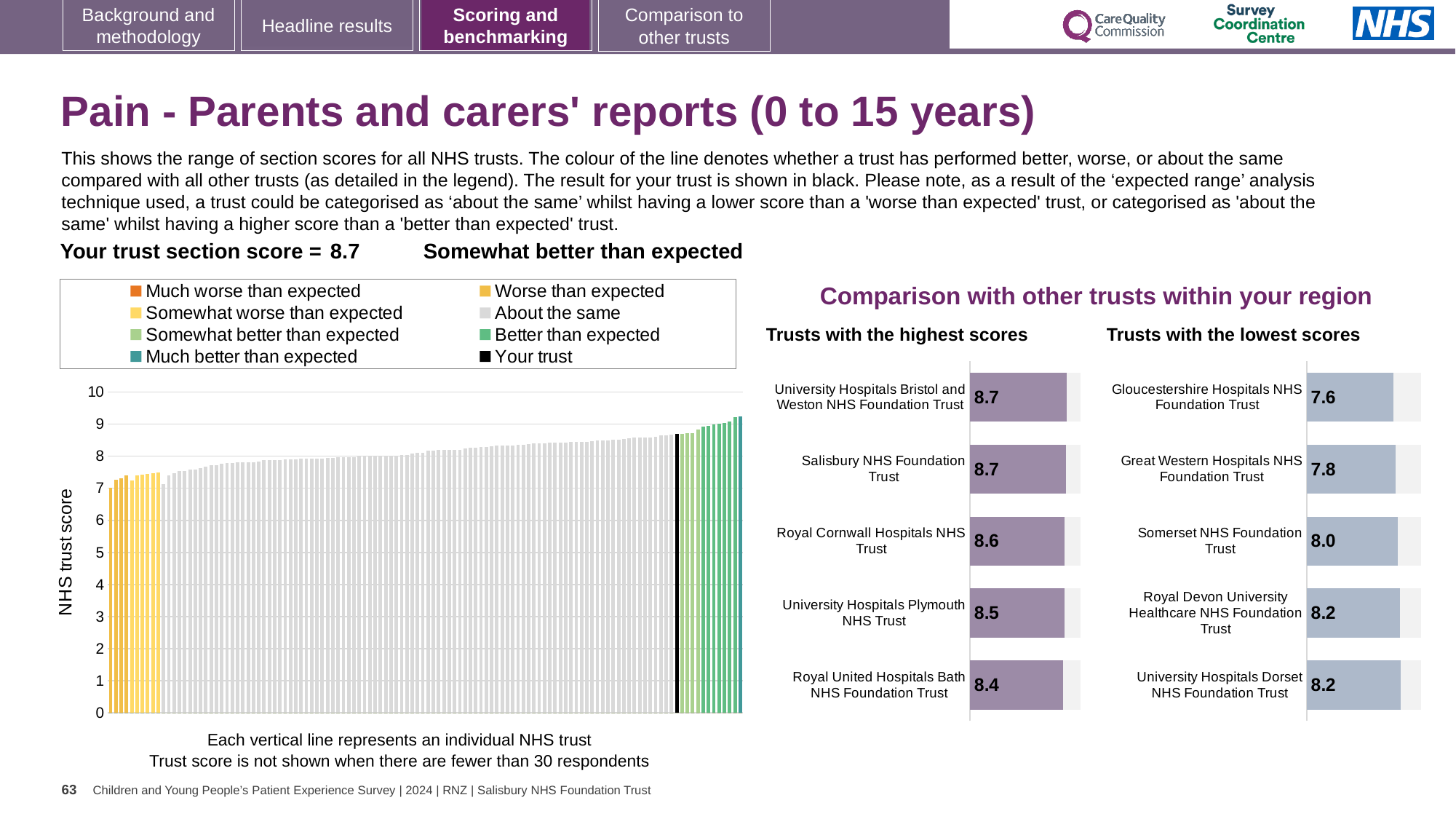
In the 'Trusts with the lowest scores' chart, what is the difference between the scores of Great Western Hospitals NHS Foundation Trust and Gloucestershire Hospitals NHS Foundation Trust? 0.2 In the 'Trusts with the lowest scores' chart, what is the score for Somerset NHS Foundation Trust? 8.0 In the 'Trusts with the lowest scores' chart, which trust has the lowest score? Gloucestershire Hospitals NHS Foundation Trust In the 'Trusts with the highest scores' chart, which trust has the lowest score shown? Royal United Hospitals Bath NHS Foundation Trust How many entries does the legend of the main chart on the left list? 8 How many trusts are listed in the 'Trusts with the lowest scores' chart? 5 In the 'Trusts with the lowest scores' chart, what is the score for Gloucestershire Hospitals NHS Foundation Trust? 7.6 In the 'Trusts with the highest scores' chart, what is the score for Royal Cornwall Hospitals NHS Trust? 8.6 In the main chart on the left, is the value for the black 'Your trust' bar greater or less than 8? greater In the 'Trusts with the highest scores' chart, what is the score for Royal United Hospitals Bath NHS Foundation Trust? 8.4 In the 'Trusts with the highest scores' chart, which is larger: the score for University Hospitals Plymouth NHS Trust or Royal United Hospitals Bath NHS Foundation Trust? University Hospitals Plymouth NHS Trust What kind of chart is the main chart on the left showing NHS trust scores? Bar chart